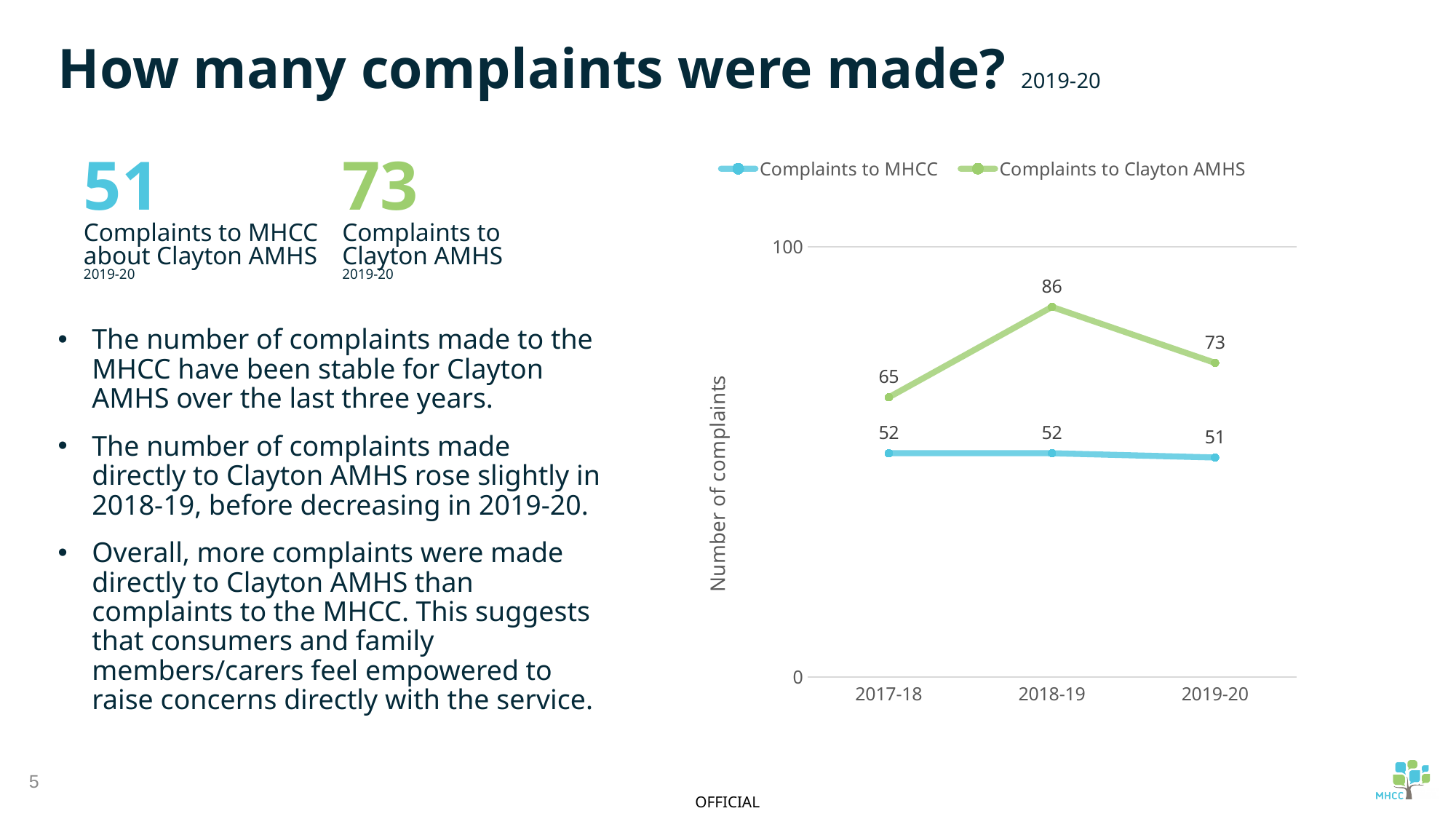
How many years are plotted along the x axis of the chart? 3 In which year was the number of Complaints to MHCC lowest? 2019-20 Does the Complaints to Clayton AMHS line rise or fall from 2018-19 to 2019-20? fall What is the value for Complaints to Clayton AMHS in 2017-18? 65 How many series does the chart legend list? 2 What kind of chart is shown on the slide? line chart Which series has the larger value in 2017-18, Complaints to MHCC or Complaints to Clayton AMHS? Complaints to Clayton AMHS What is the value for Complaints to MHCC in 2019-20? 51 What is the difference between Complaints to Clayton AMHS and Complaints to MHCC in 2018-19? 34 What is the value for Complaints to Clayton AMHS in 2018-19? 86 In which year was the number of Complaints to Clayton AMHS highest? 2018-19 What is the label of the chart's vertical axis? Number of complaints